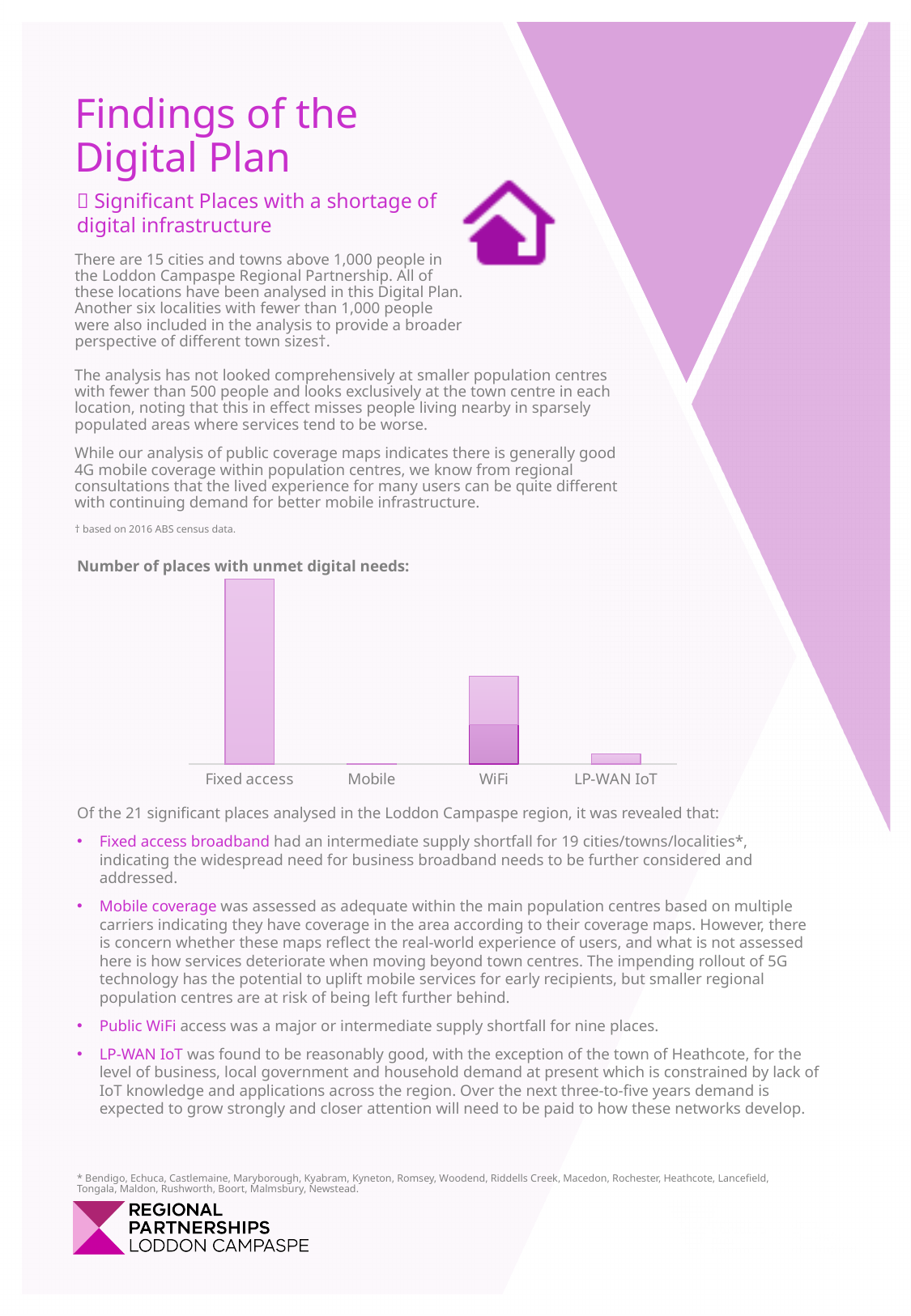
Which category has the tallest bar in the chart? Fixed access Which category has the smallest bar in the chart? Mobile Which category's bar is split into two differently shaded segments? WiFi Which bar is taller, WiFi or LP-WAN IoT? WiFi How many categories are shown on the x axis of the chart? 4 What is the label of the second category from the left on the x axis? Mobile Which bar is taller, Fixed access or WiFi? Fixed access What is the title of the chart? Number of places with unmet digital needs: Do the bar heights consistently decrease from left to right across the chart? No What kind of chart is shown under "Number of places with unmet digital needs"? Bar chart Which bar is taller, Mobile or LP-WAN IoT? LP-WAN IoT